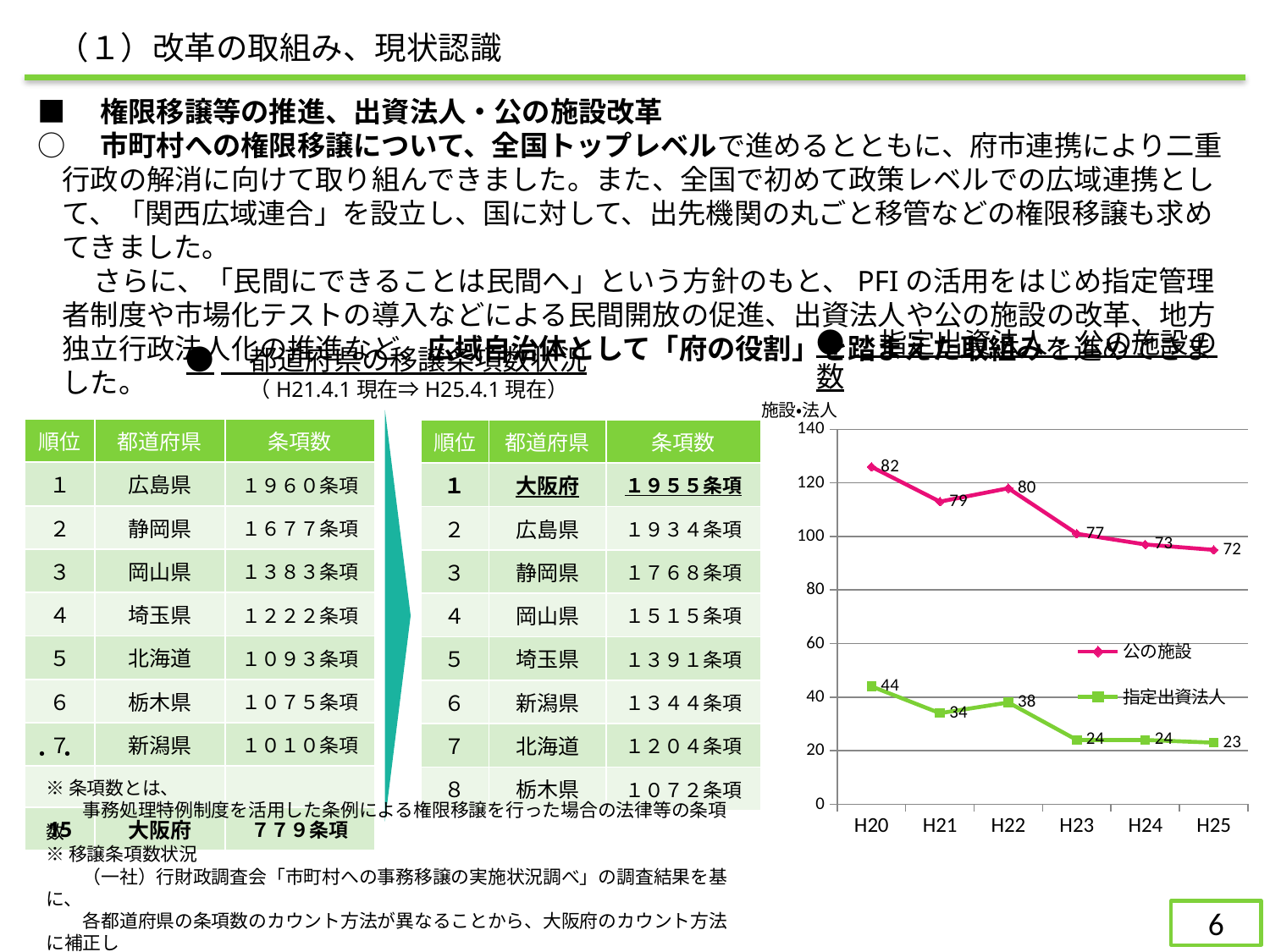
In the line chart, what is the value for 公の施設 in H20? 82 What kind of chart is shown on the right side of the slide? line chart In the line chart, what is the value for 指定出資法人 in H21? 34 In the line chart, what is the difference between the 指定出資法人 values in H22 and H23? 14 How many series does the legend of the line chart list? 2 In the line chart, what is the value for 指定出資法人 in H23? 24 In the line chart, in which year is 公の施設 lowest? H25 In the line chart, in which year is 指定出資法人 highest? H20 In the line chart, what is the difference between the 公の施設 values in H20 and H25? 10 How many years are plotted on the x axis of the line chart? 6 In the line chart, which is larger in H22: 公の施設 or 指定出資法人? 公の施設 In the line chart, what is the value for 公の施設 in H25? 72